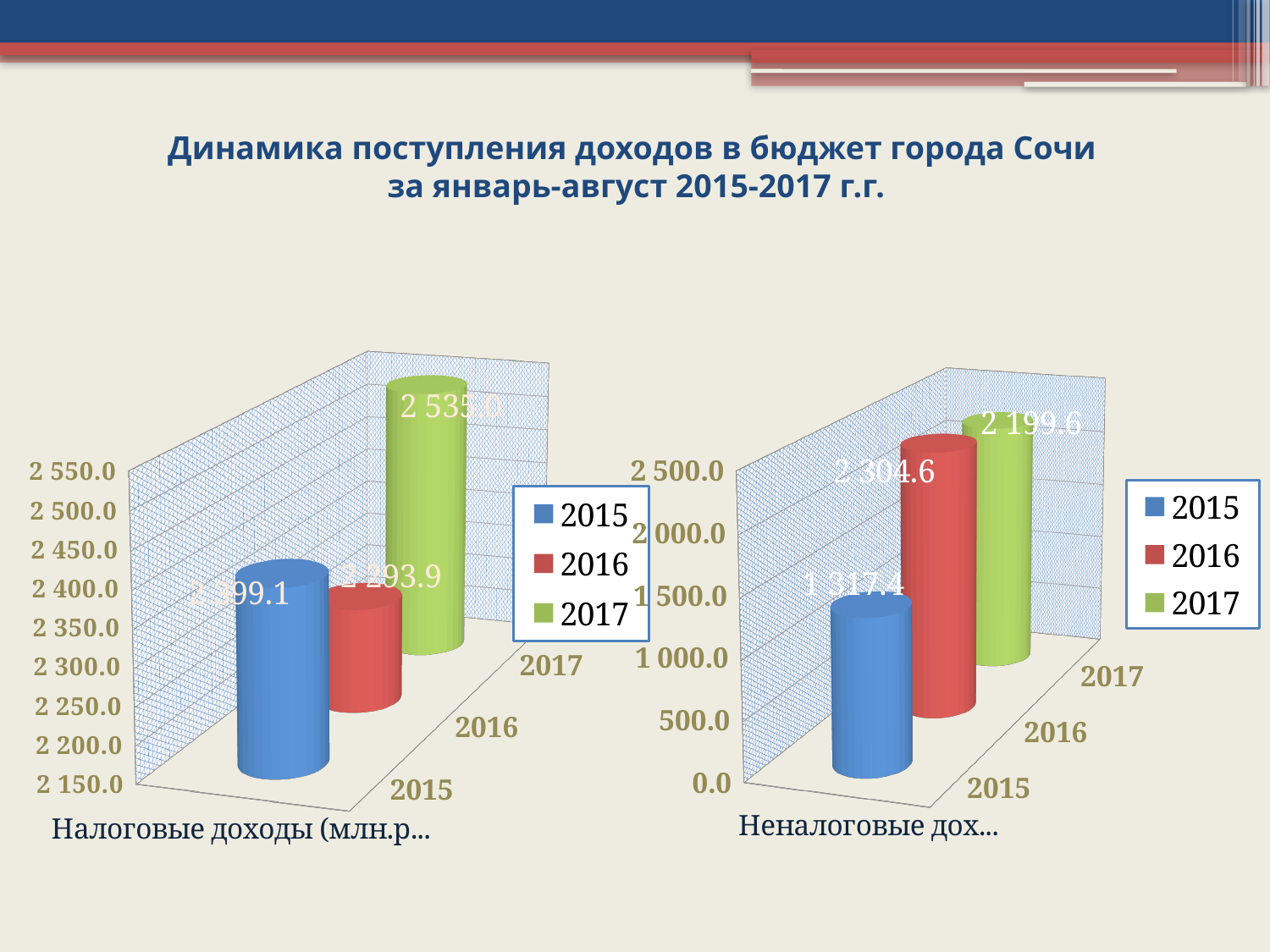
On the left chart (Налоговые доходы), which year has the lowest value? 2016 On the right chart (Неналоговые доходы), which year has the lowest value? 2015 On the left chart (Налоговые доходы), is the value for 2015 greater or less than 2 350.0? greater On the right chart (Неналоговые доходы), what is the value for 2015? 1 317.4 On the left chart (Налоговые доходы), which year has the highest value? 2017 On the right chart (Неналоговые доходы), which year has the highest value? 2016 What kind of chart is the left chart (Налоговые доходы)? bar chart How many series does the legend of the right chart list? 3 On the right chart (Неналоговые доходы), what is the value for 2016? 2 304.6 On the right chart (Неналоговые доходы), what is the value for 2017? 2 199.6 On the left chart (Налоговые доходы), what is the value for 2017? 2 535.0 On the right chart (Неналоговые доходы), what is the difference between the 2016 and 2015 values? 987.2